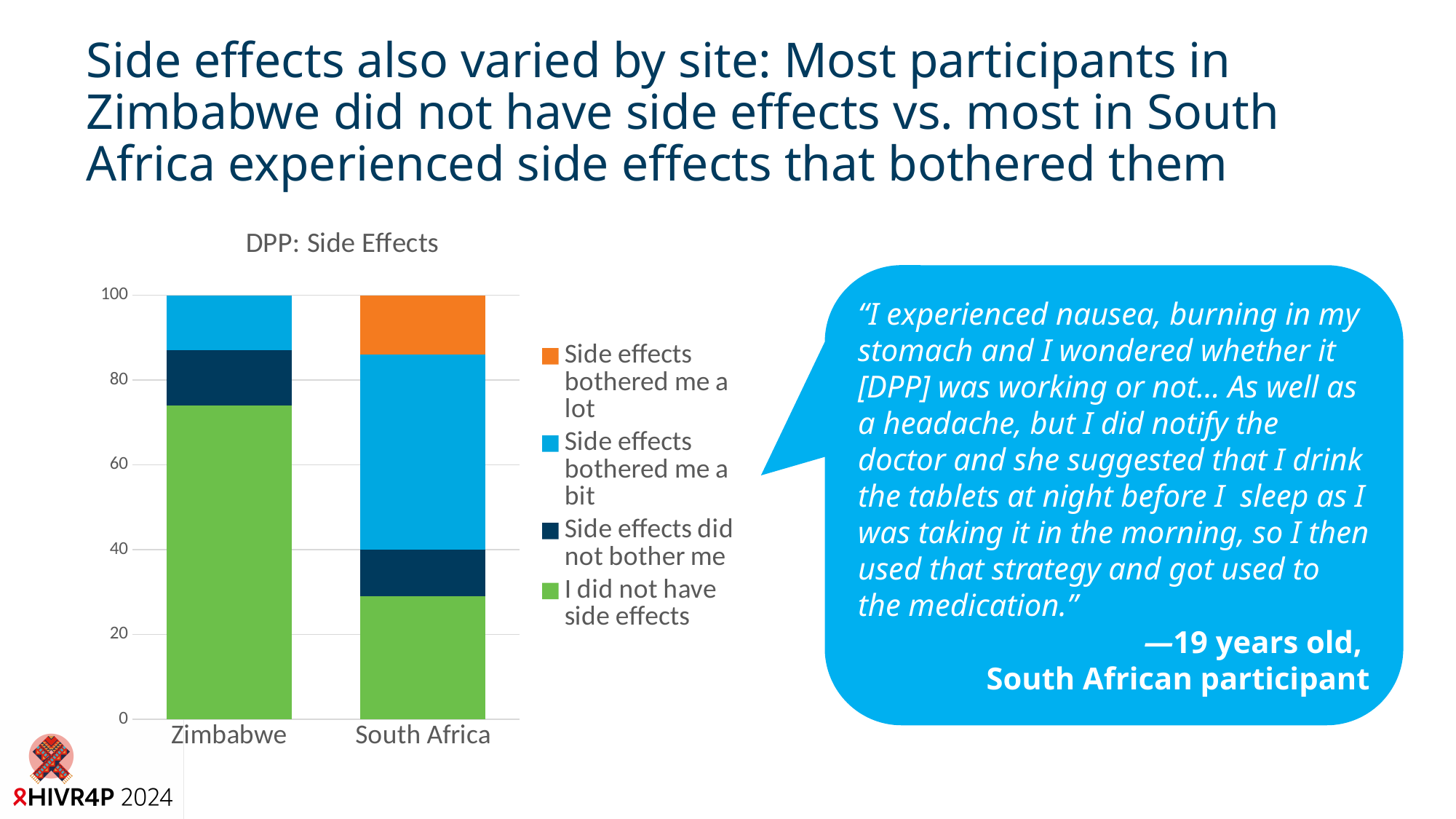
What is the total height of the stacked bar for Zimbabwe? 100 What kind of chart is shown on the slide? Stacked bar chart Which site has the larger 'I did not have side effects' segment, Zimbabwe or South Africa? Zimbabwe Is the value for 'I did not have side effects' in South Africa greater or less than 40? less Which series is the largest segment in the Zimbabwe bar? I did not have side effects How many categories (sites) are shown on the x axis of the chart? 2 Is the value for 'Side effects bothered me a lot' in South Africa greater or less than 20? less Which legend entry is shown in orange? Side effects bothered me a lot What is the title of the chart? DPP: Side Effects How many series does the chart legend list? 4 Is the value for 'I did not have side effects' in Zimbabwe greater or less than 60? greater Which series is the largest segment in the South Africa bar? Side effects bothered me a bit